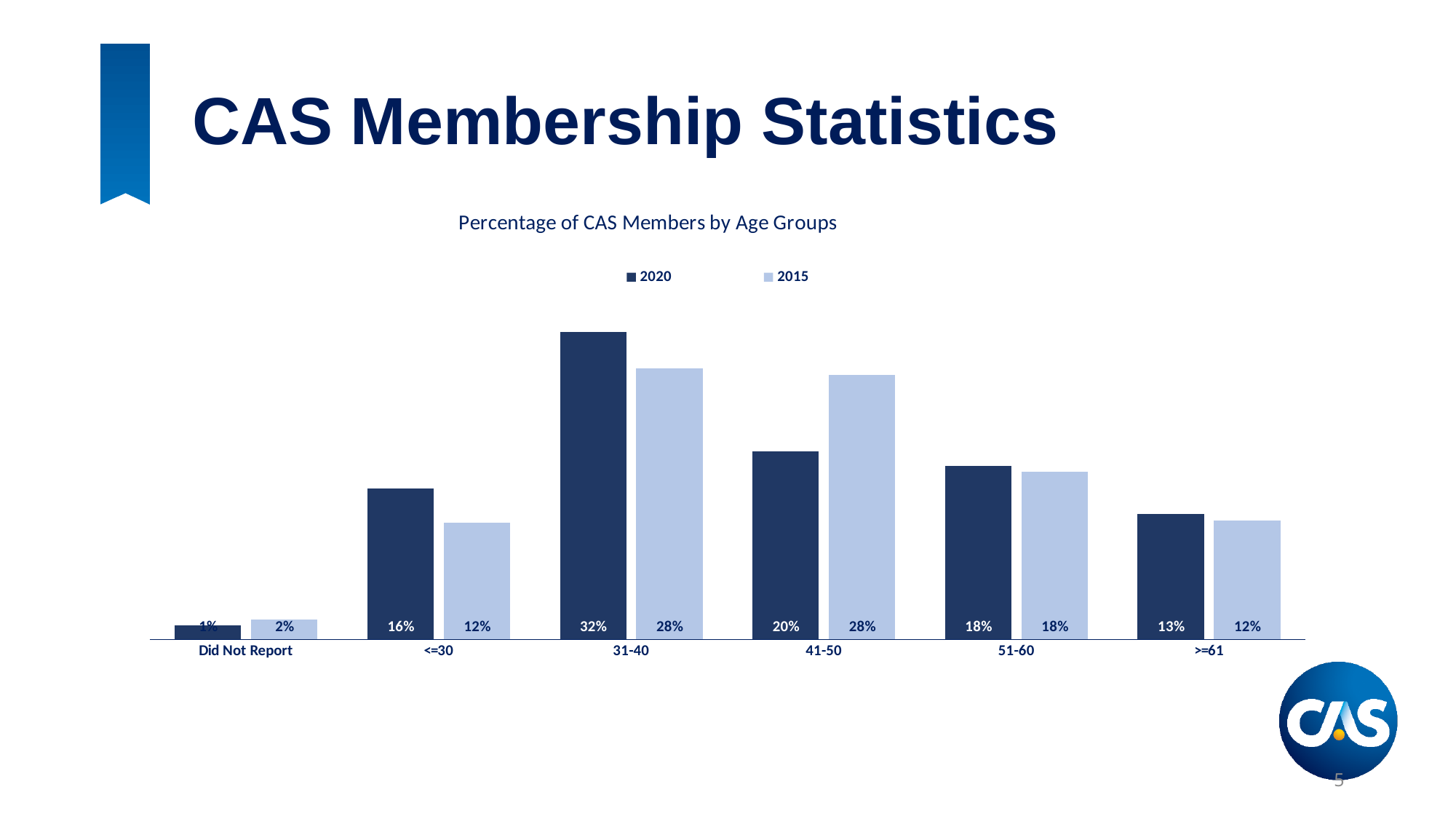
What is the difference between the 2020 and 2015 values for the 41-50 age group? 8% Which is larger for the <=30 age group, the 2020 value or the 2015 value? 2020 What is the 2020 value for the <=30 age group? 16% Which category has the lowest percentage for 2015? Did Not Report What kind of chart is shown on the slide? Bar chart What is the title of the chart? Percentage of CAS Members by Age Groups Which age group has the highest percentage for 2020? 31-40 How many age group categories are shown on the x axis? 6 How many series does the legend list? 2 Which years are listed in the chart legend? 2020 and 2015 What percentage of CAS members were in the 31-40 age group in 2020? 32% What percentage of CAS members were in the 41-50 age group in 2015? 28%